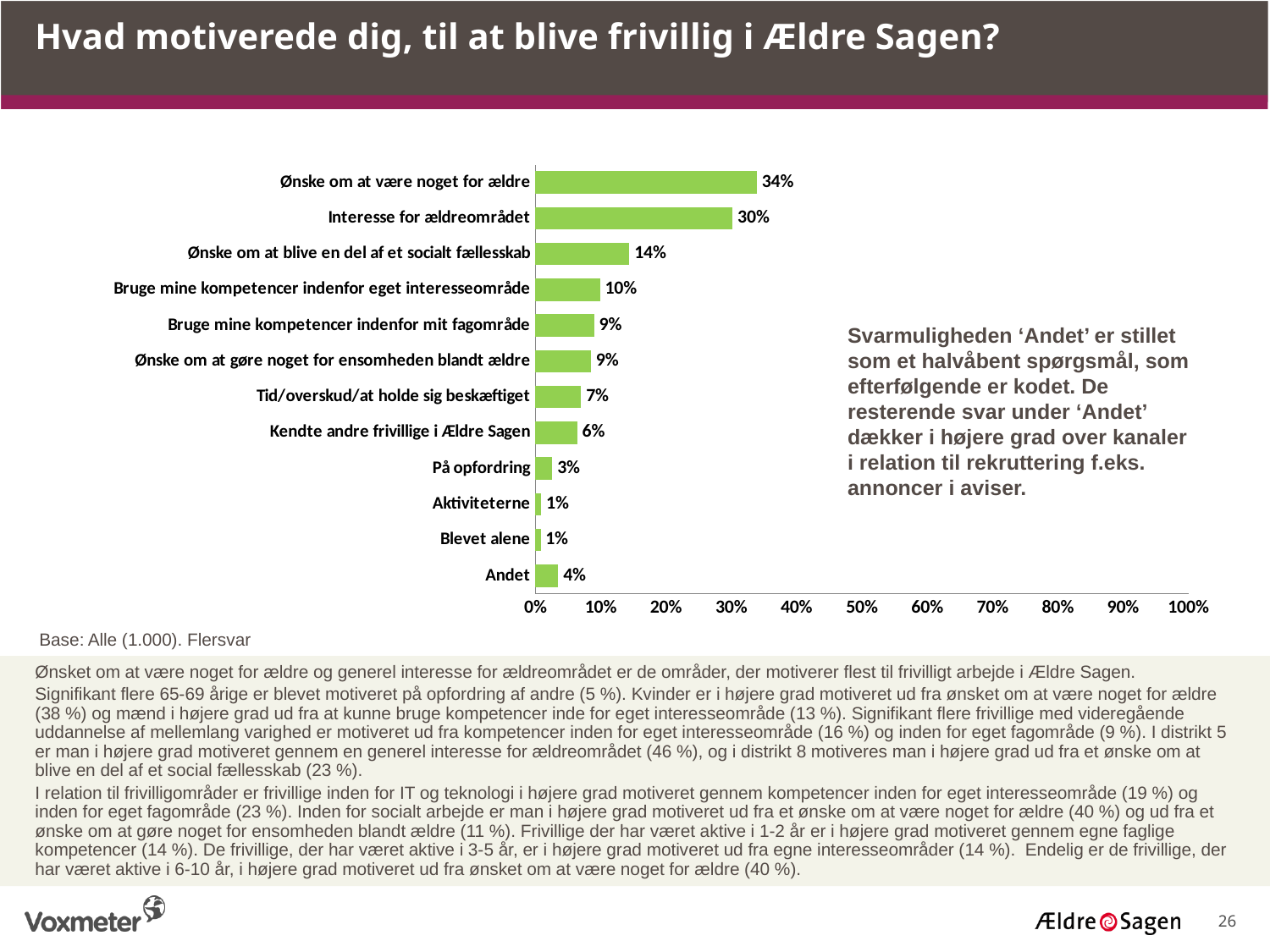
Which category has the highest value? Ønske om at være noget for ældre How many categories are shown in the chart? 12 What kind of chart is shown on the slide? Bar chart What is the value for "Andet"? 4% Which is larger, "Tid/overskud/at holde sig beskæftiget" or "På opfordring"? Tid/overskud/at holde sig beskæftiget What is the value for "Ønske om at være noget for ældre"? 34% What is the value for "Kendte andre frivillige i Ældre Sagen"? 6% Is the value for "Interesse for ældreområdet" greater or less than 20%? greater What is the difference between "Ønske om at være noget for ældre" and "Interesse for ældreområdet"? 4% What is the value for "Interesse for ældreområdet"? 30% What is the difference between "Ønske om at blive en del af et socialt fællesskab" and "Bruge mine kompetencer indenfor eget interesseområde"? 4% What is the maximum value shown on the x axis? 100%